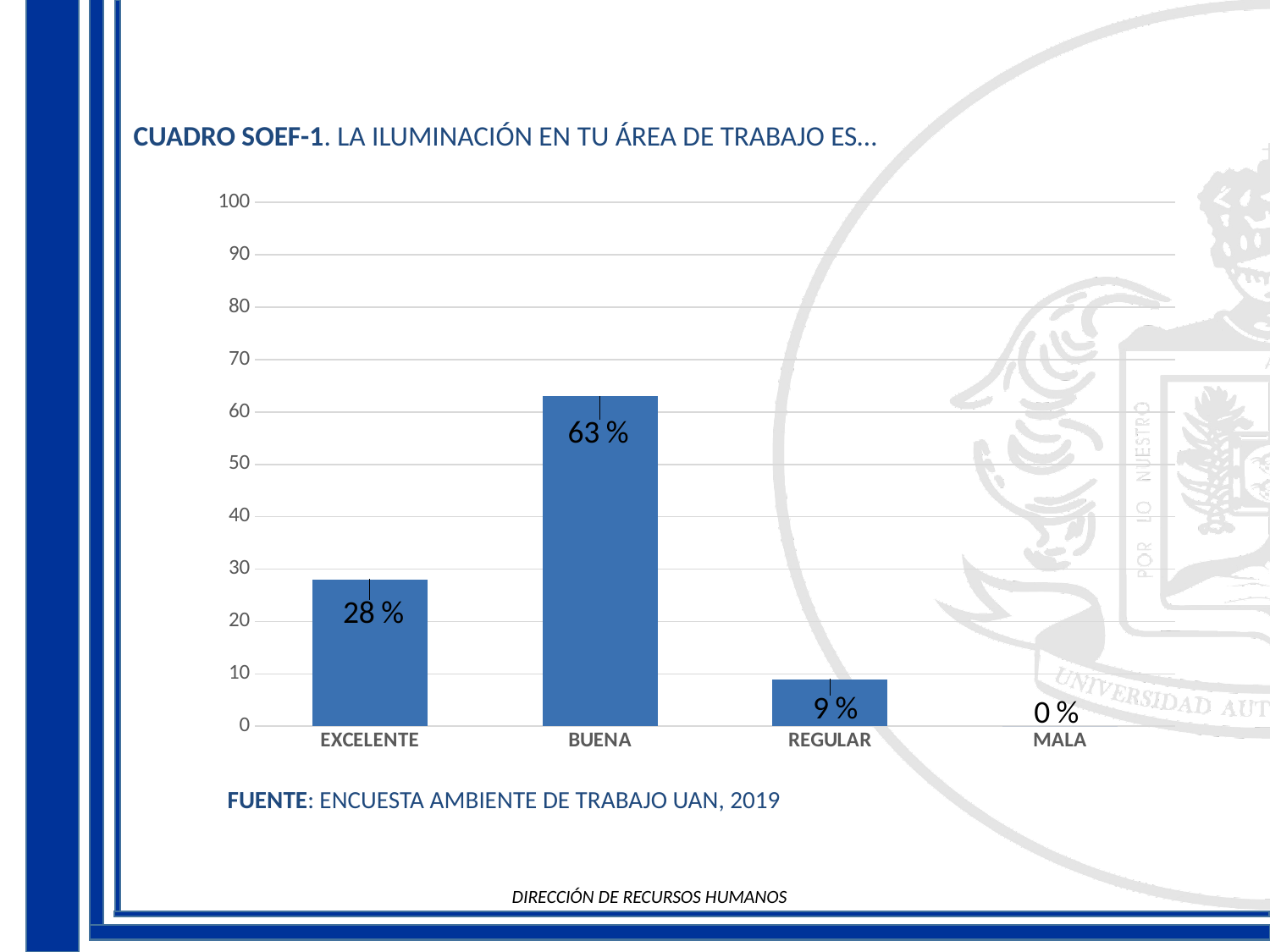
What is the difference between the values for BUENA and EXCELENTE? 35 % What kind of chart is shown on the slide? bar chart What is the value for MALA? 0 % What is the value for BUENA? 63 % Which category has the lowest value? MALA Is the value for BUENA greater or less than 50? greater What is the value for REGULAR? 9 % Which is larger, the value for EXCELENTE or the value for REGULAR? EXCELENTE Which category has the highest value? BUENA How many categories are shown on the x axis? 4 What source is cited below the chart? ENCUESTA AMBIENTE DE TRABAJO UAN, 2019 What is the value for EXCELENTE? 28 %